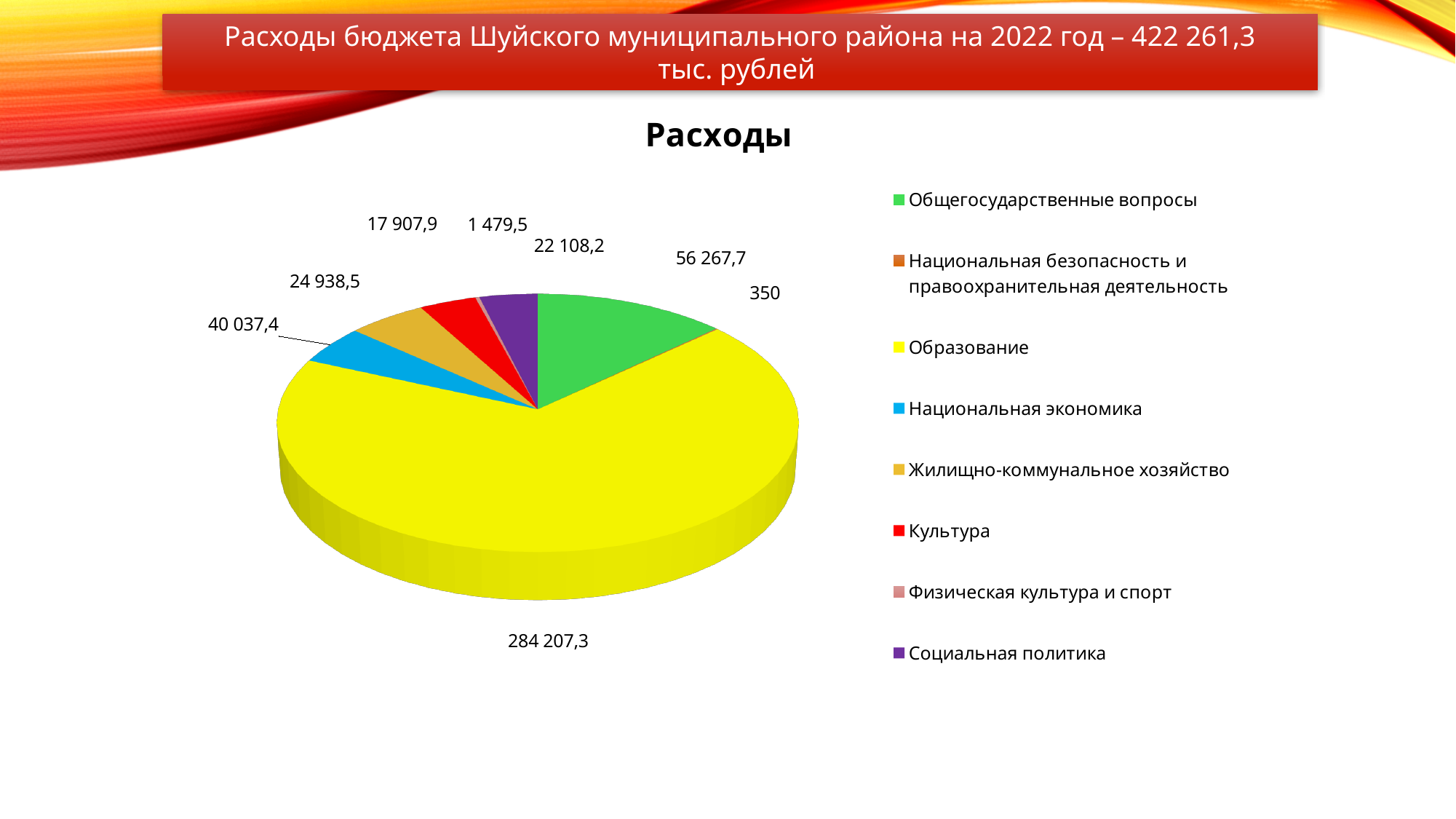
What is the value for Социальная политика? 22 108,2 Which category has the smallest value? Национальная безопасность и правоохранительная деятельность What is the value for Общегосударственные вопросы? 56 267,7 Which is larger, the value for Жилищно-коммунальное хозяйство or the value for Культура? Жилищно-коммунальное хозяйство What is the value for Национальная экономика? 40 037,4 What is the difference between the values for Общегосударственные вопросы and Национальная экономика? 16 230,3 What type of chart is shown on the slide? pie chart What is the value for Образование? 284 207,3 What is the title of the chart? Расходы Which category has the largest slice of the pie? Образование What is the value for Физическая культура и спорт? 1 479,5 How many categories does the legend list? 8